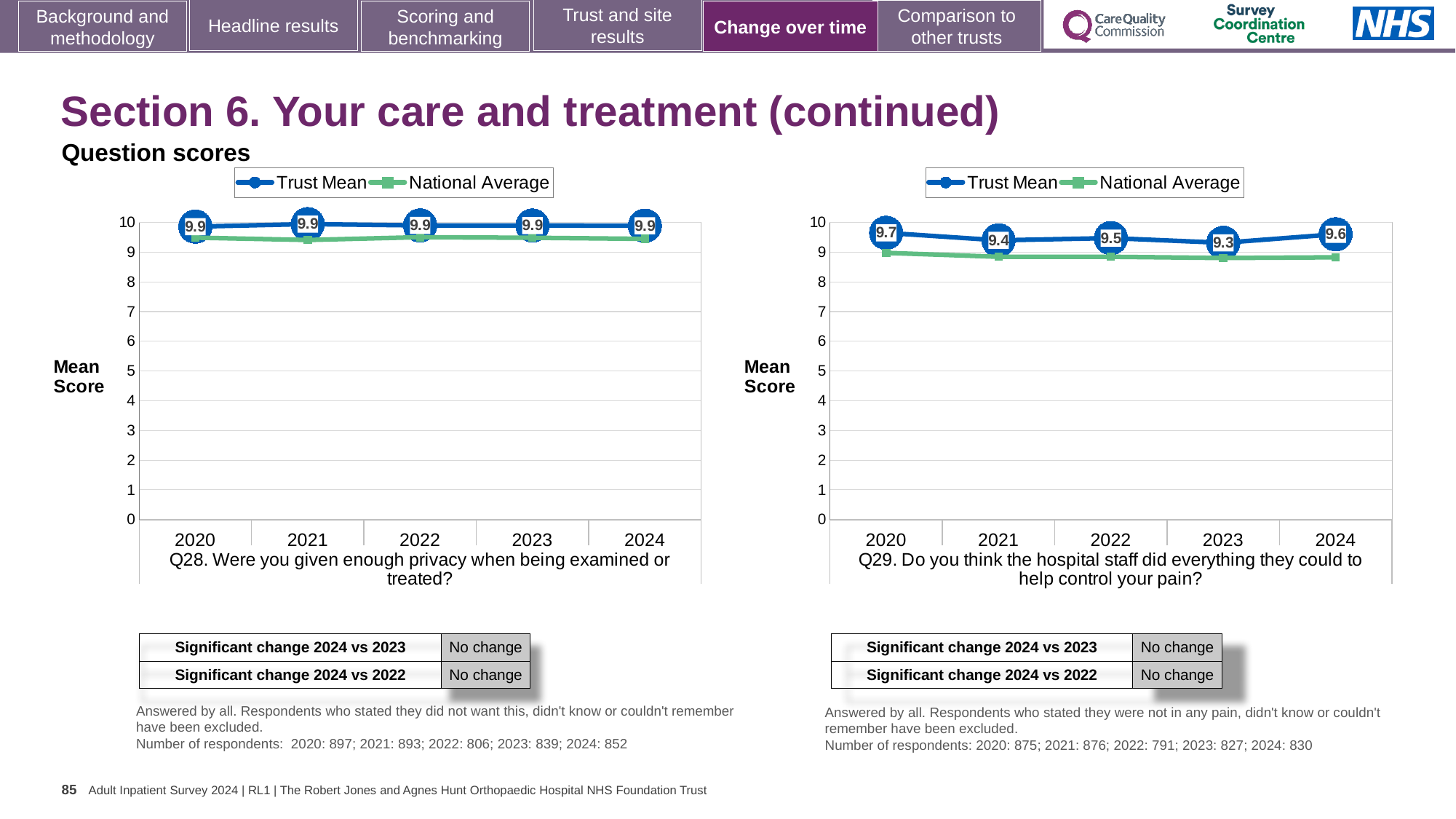
In the Q28 chart (left), what is the Trust Mean score for 2024? 9.9 How many series does the legend of the Q29 chart (right) list? 2 In the Q28 chart (left), does the Trust Mean score rise, fall or stay the same from 2020 to 2024? Stays the same In the Q29 chart (right), which year has the lowest Trust Mean score? 2023 In the Q29 chart (right), is the Trust Mean score higher in 2024 or in 2023? 2024 In the Q29 chart (right), which year has the highest Trust Mean score? 2020 In the Q29 chart (right), what is the difference between the Trust Mean scores for 2020 and 2023? 0.4 In the Q29 chart (right), what is the Trust Mean score for 2021? 9.4 What type of chart is used for Q28 (left)? Line chart In the Q28 chart (left), is the National Average value for 2024 greater or less than 9? greater In the Q29 chart (right), what is the Trust Mean score for 2024? 9.6 How many years are plotted on the x axis of the Q28 chart (left)? 5